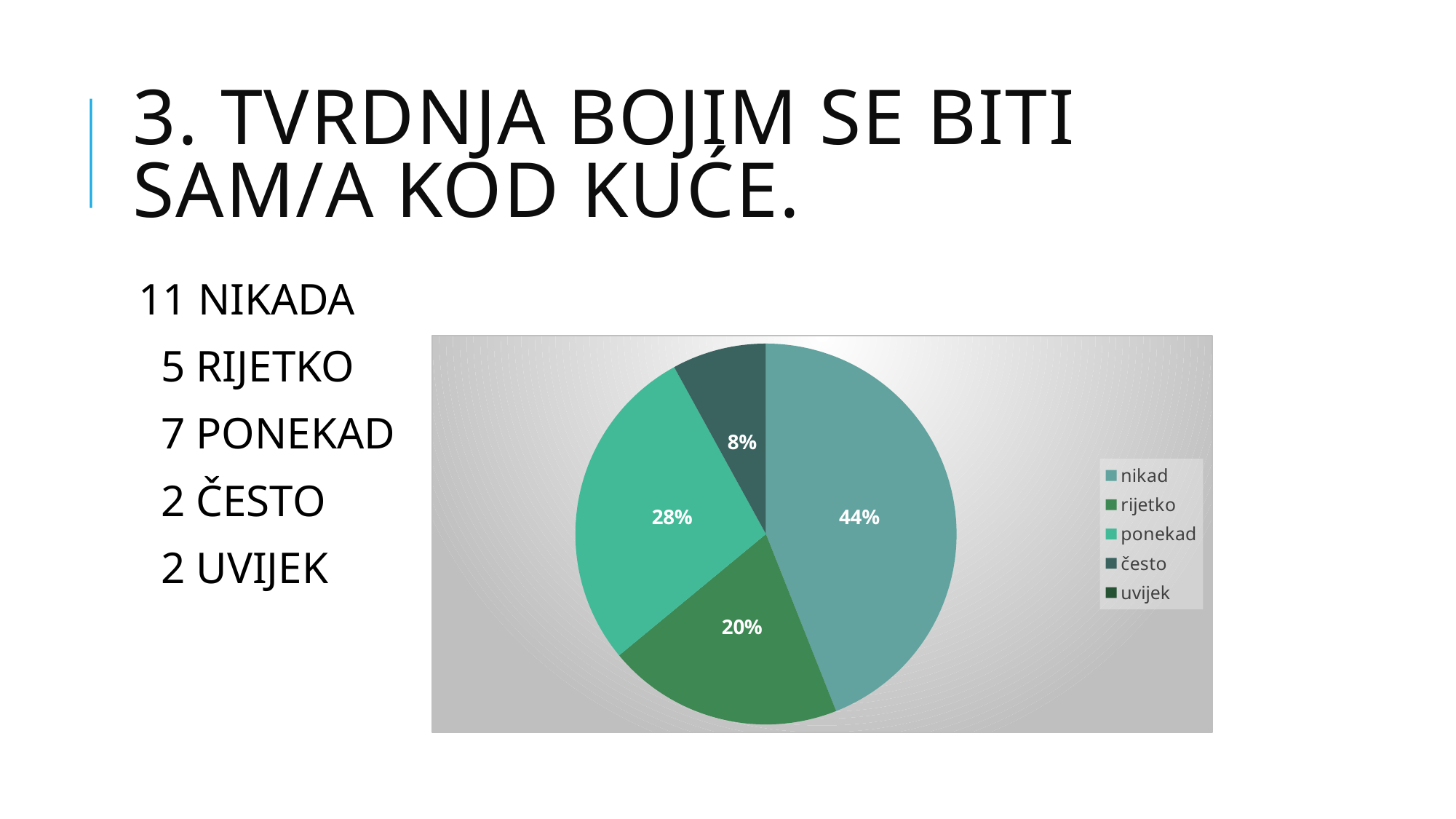
What is the difference in percentage points between the 'ponekad' and 'često' slices? 20 Which category has the largest slice of the pie chart? nikad What percentage is shown for the 'rijetko' slice? 20% What percentage of the pie chart does the 'nikad' slice represent? 44% Which labelled slice of the pie chart is the smallest? često What percentage is shown for the 'često' slice? 8% What type of chart is shown on the slide? pie chart What is the difference in percentage points between the 'nikad' and 'rijetko' slices? 24 Which slice is larger, 'nikad' or 'ponekad'? nikad How many entries does the chart legend list? 5 What percentage is shown for the 'ponekad' slice? 28% Which legend entry is listed first in the chart legend? nikad